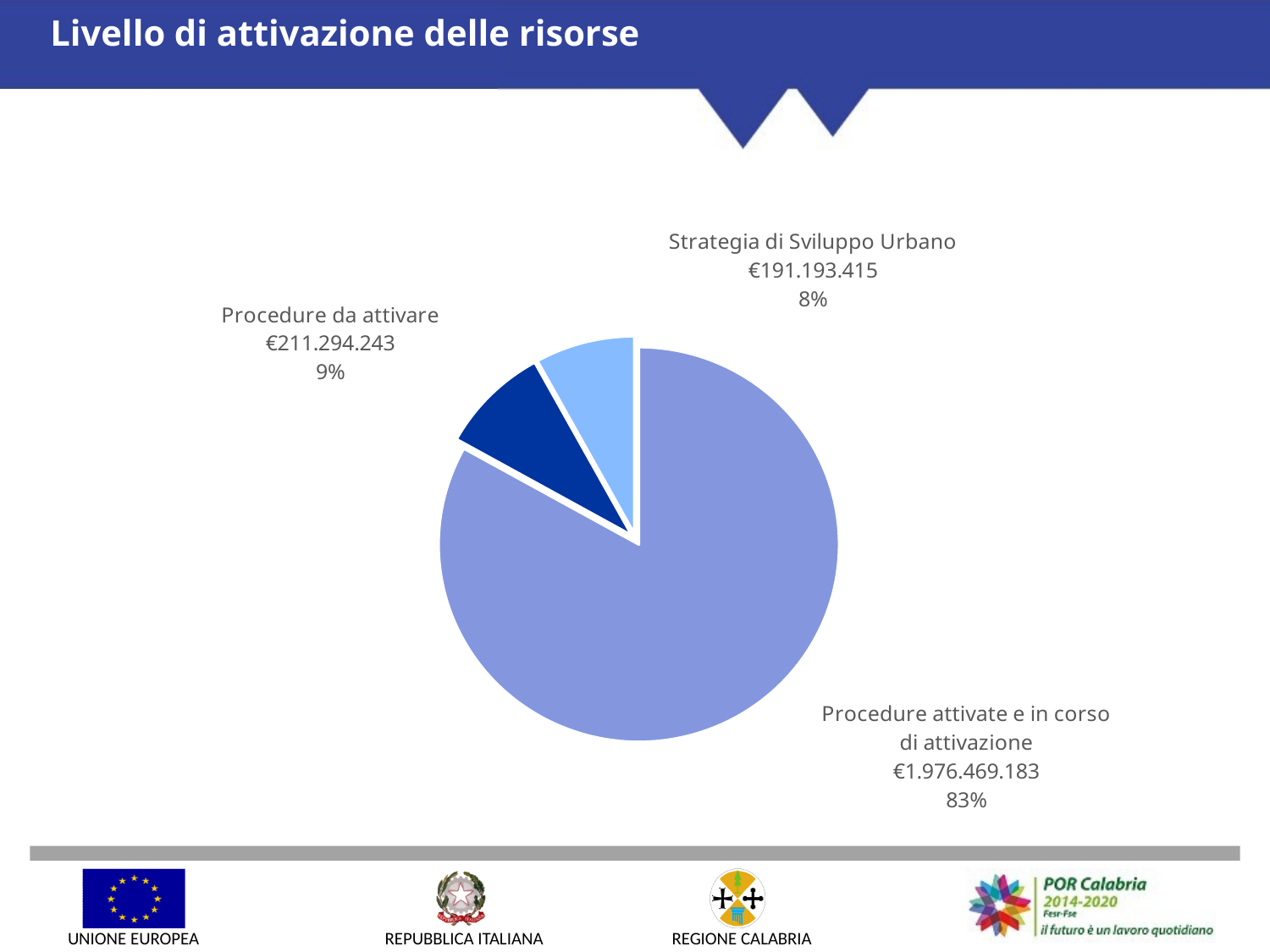
What is the value shown for Procedure attivate e in corso di attivazione? €1.976.469.183 Which is larger, the value for Procedure da attivare or the value for Strategia di Sviluppo Urbano? Procedure da attivare What is the difference in euros between Procedure da attivare and Strategia di Sviluppo Urbano? €20.100.828 What is the title of the slide containing the pie chart? Livello di attivazione delle risorse How many slices does the pie chart have? 3 What kind of chart is shown on the slide? pie chart Which slice of the pie chart is the smallest? Strategia di Sviluppo Urbano Which slice of the pie chart is the largest? Procedure attivate e in corso di attivazione What is the value shown for Procedure da attivare? €211.294.243 What is the value shown for Strategia di Sviluppo Urbano? €191.193.415 What share of the pie does Procedure attivate e in corso di attivazione represent? 83% What share of the pie does Strategia di Sviluppo Urbano represent? 8%